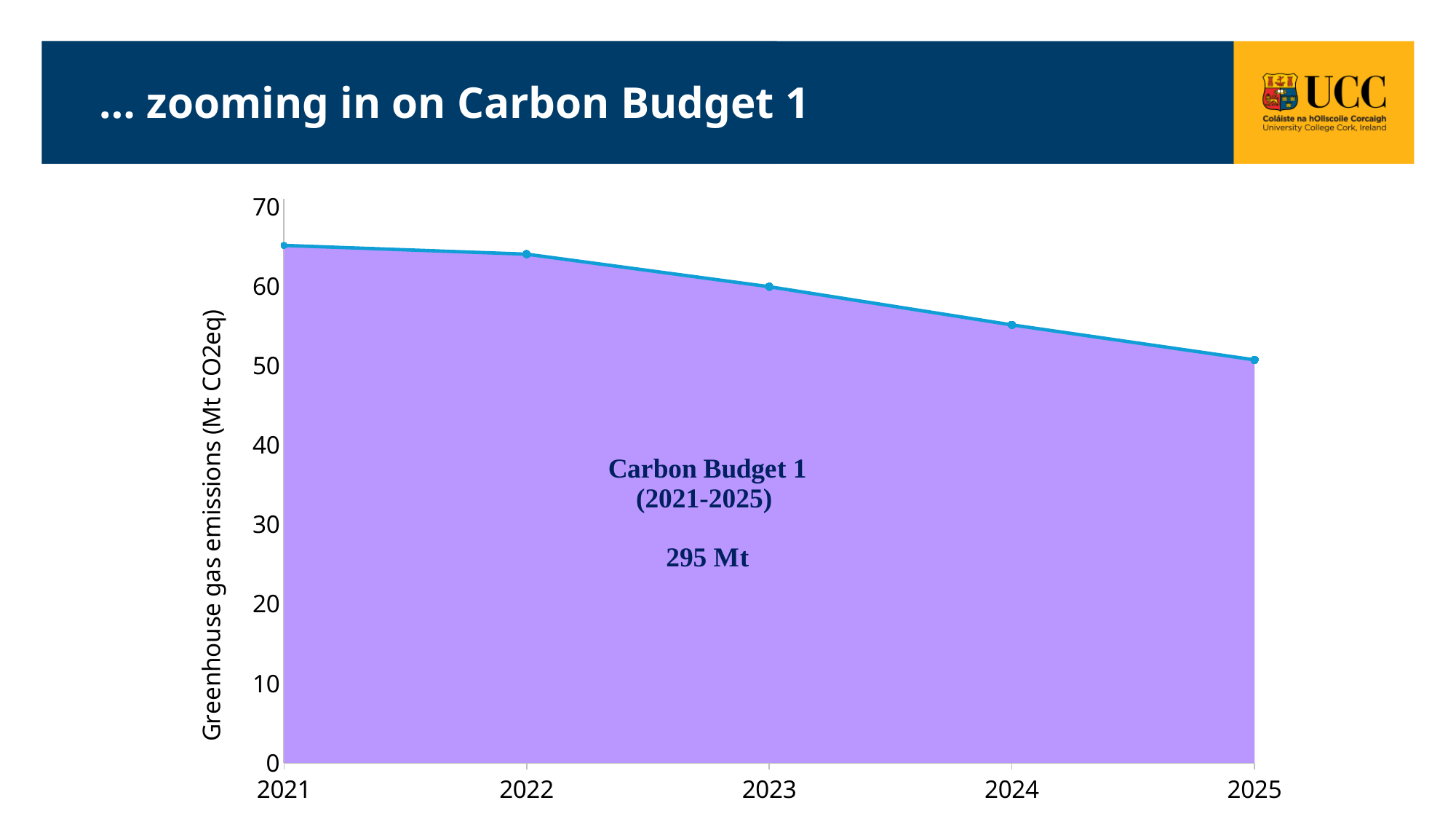
Is the value for 2025 greater or less than 60? less What is the label on the y axis? Greenhouse gas emissions (Mt CO2eq) Is the value for 2021 greater or less than 60? greater How many years are plotted along the x axis? 5 Which year has the lowest greenhouse gas emissions? 2025 Which year has the highest greenhouse gas emissions? 2021 Which year has higher emissions, 2023 or 2024? 2023 Is the value for 2024 greater or less than 60? less Do greenhouse gas emissions rise or fall from 2021 to 2025? fall What kind of chart is shown on the slide? area chart What total amount is printed inside the shaded area for Carbon Budget 1? 295 Mt